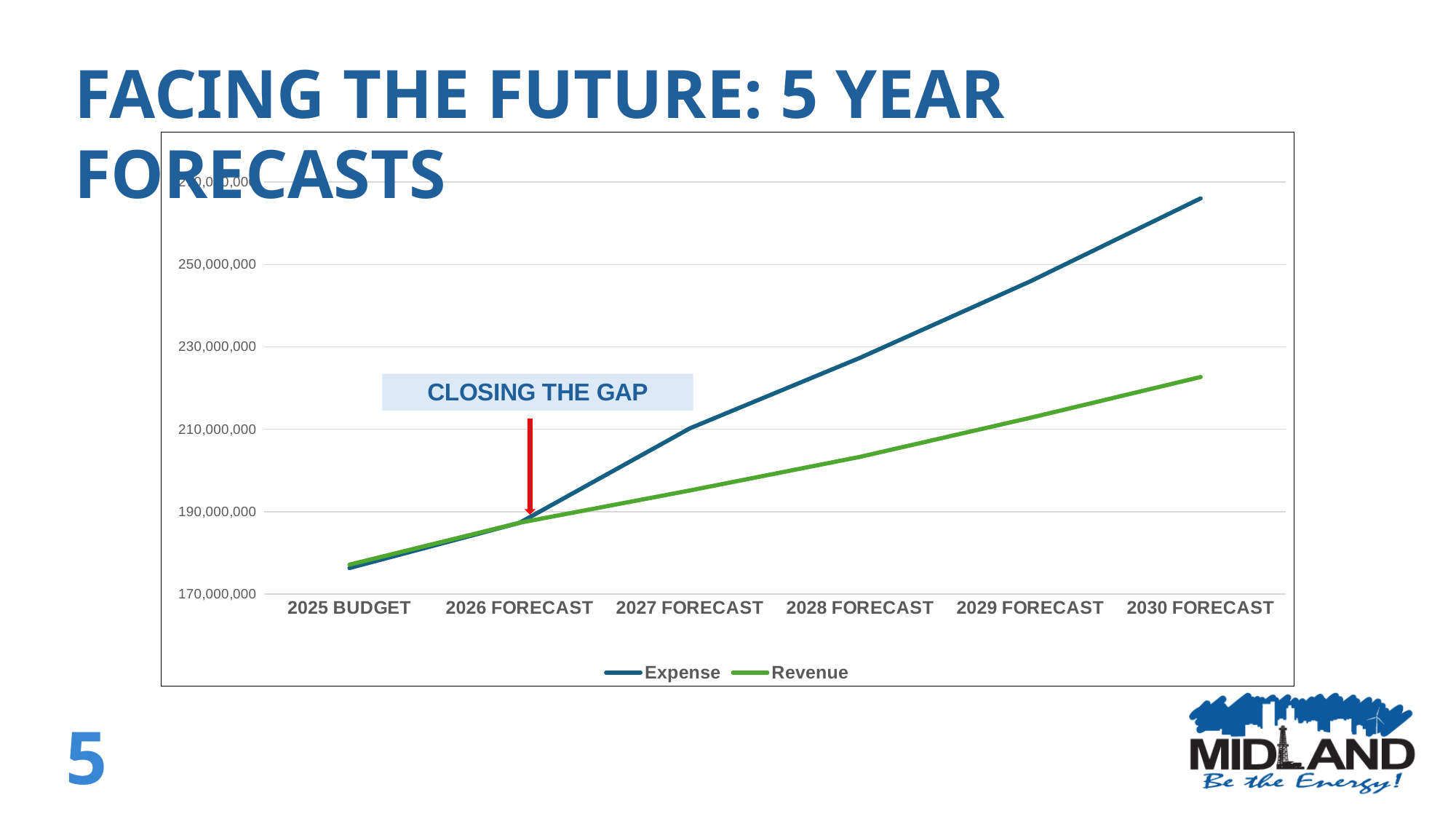
At 2030 FORECAST, which is larger, Expense or Revenue? Expense What text appears in the annotation box above the red arrow on the chart? CLOSING THE GAP Does the Expense line rise or fall from 2025 BUDGET to 2030 FORECAST? Rises Is the Expense value for 2030 FORECAST greater or less than 250,000,000? greater In which category does the Expense line reach its highest value? 2030 FORECAST Does the Revenue line rise or fall from 2025 BUDGET to 2030 FORECAST? Rises In which category is the Revenue line at its lowest value? 2025 BUDGET How many series does the chart's legend list? 2 How many categories are shown along the x axis of the chart? 6 What kind of chart is shown on the slide? Line chart Is the Revenue value for 2030 FORECAST greater or less than 230,000,000? less Is the Revenue value for 2028 FORECAST greater or less than 190,000,000? greater